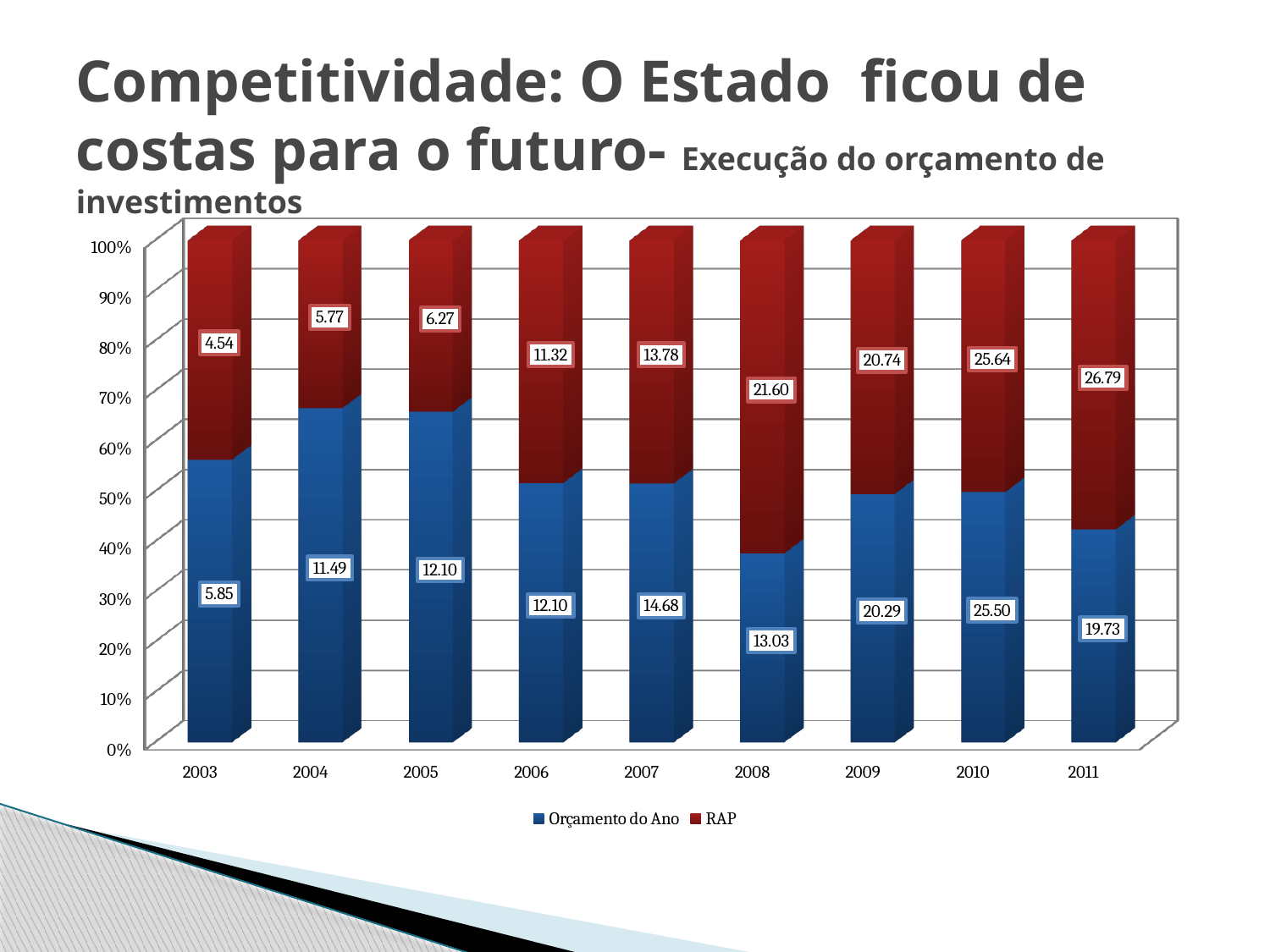
In which year is the RAP value highest? 2011 Do the RAP values generally rise or fall from 2003 to 2011? Rise What is the value of Orçamento do Ano for 2010? 25.50 Is the share of the 2003 bar taken by Orçamento do Ano greater or less than 50%? greater What is the value of Orçamento do Ano for 2003? 5.85 How many years are shown on the x axis? 9 How many series does the legend list? 2 What is the difference between the RAP value and the Orçamento do Ano value for 2011? 7.06 What kind of chart is shown on the slide? Stacked bar chart For 2008, which is larger: Orçamento do Ano or RAP? RAP In which year is the Orçamento do Ano value lowest? 2003 What is the value of RAP for 2008? 21.60